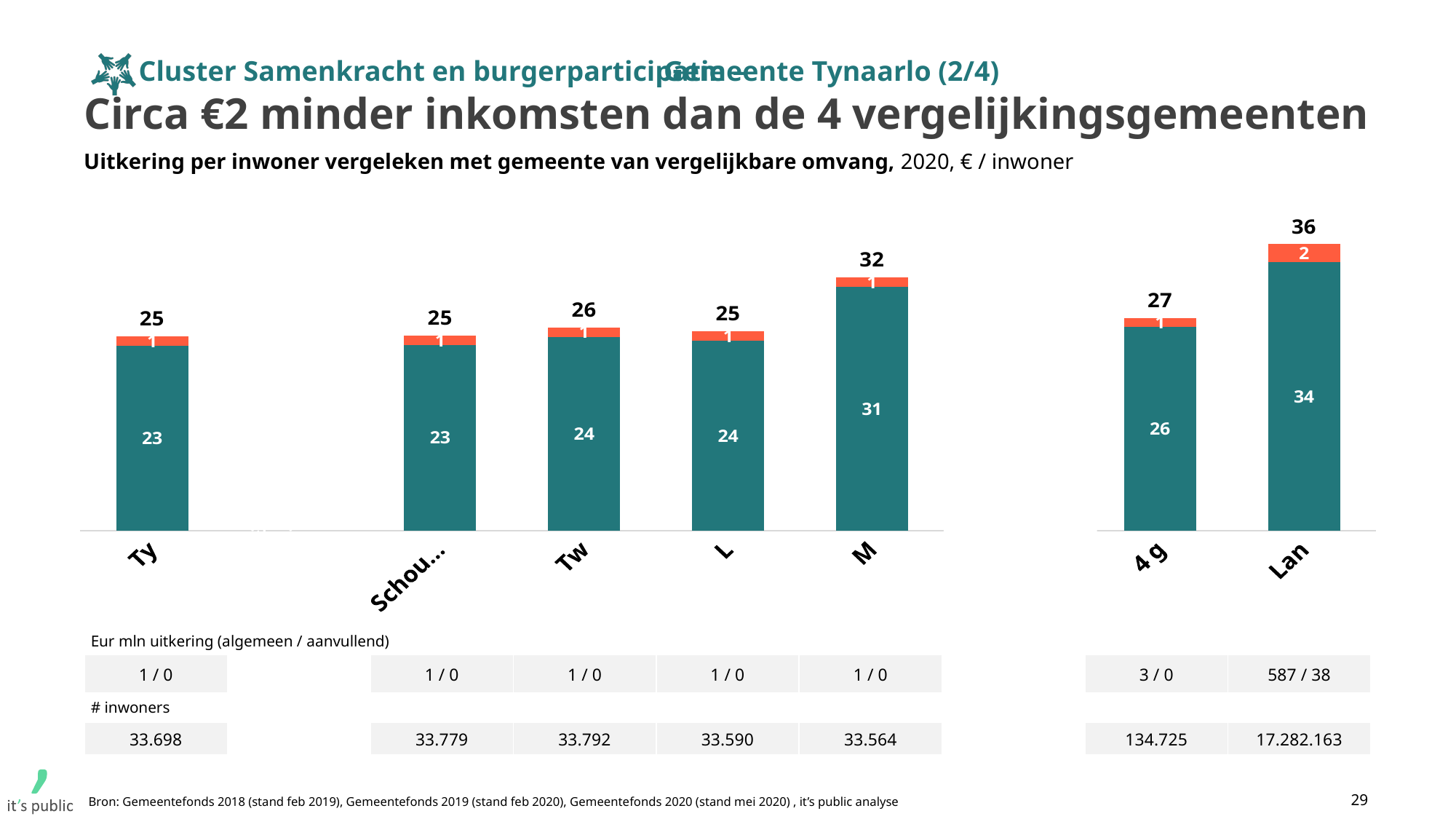
What is the total value shown above the bar for Ty? 25 Which is larger, the total for M or the total for 4 g? M How many bars are plotted in the chart? 7 What is the difference between the teal segment for M and the teal segment for Ty? 8 Which category has the highest total value? Lan What is the value of the teal (bottom) segment of the bar for Tw? 24 What is the total value shown above the bar for 4 g? 27 What kind of chart is shown on the slide? Stacked bar chart What is the total value shown above the bar for Lan? 36 What is the difference between the total for Lan and the total for Ty? 11 What is the value of the orange (top) segment of the bar for Lan? 2 What is the value of the teal (bottom) segment of the bar for M? 31